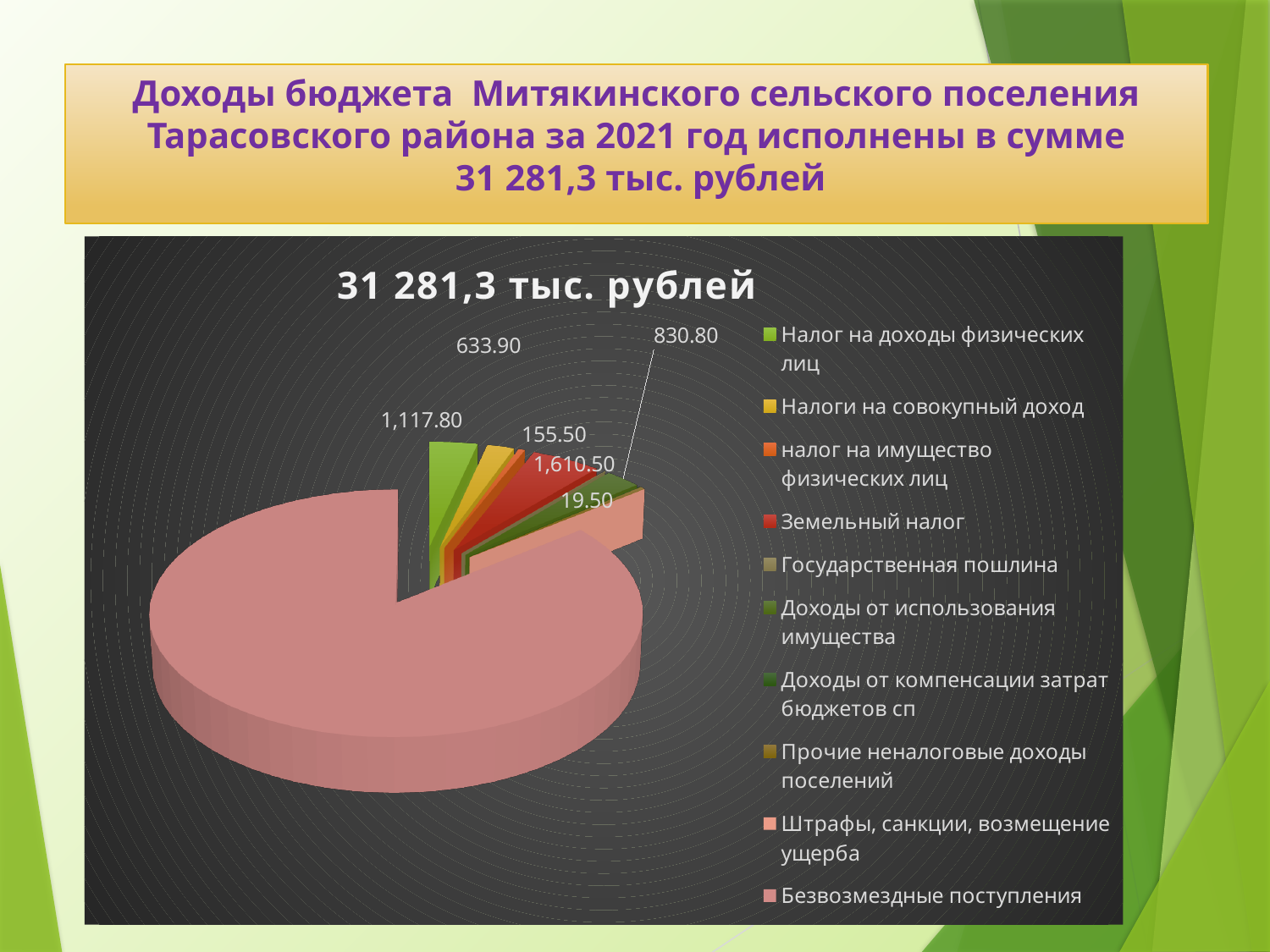
Which legend entry is listed last? Безвозмездные поступления What value is shown for Земельный налог? 1,610.50 What is the smallest data label printed on the chart? 19.50 How many categories does the chart's legend list? 10 What is the largest data label printed on the chart? 1,610.50 Which is larger, the slice for Земельный налог or the slice for Налог на доходы физических лиц? Земельный налог What value is shown for Налог на доходы физических лиц? 1,117.80 What is the title of the chart? 31 281,3 тыс. рублей Which category has the largest slice of the pie? Безвозмездные поступления What is the difference between the values for Земельный налог (1,610.50) and Налог на доходы физических лиц (1,117.80)? 492.70 How many data labels are printed on the pie? 6 What kind of chart is shown on the slide? pie chart